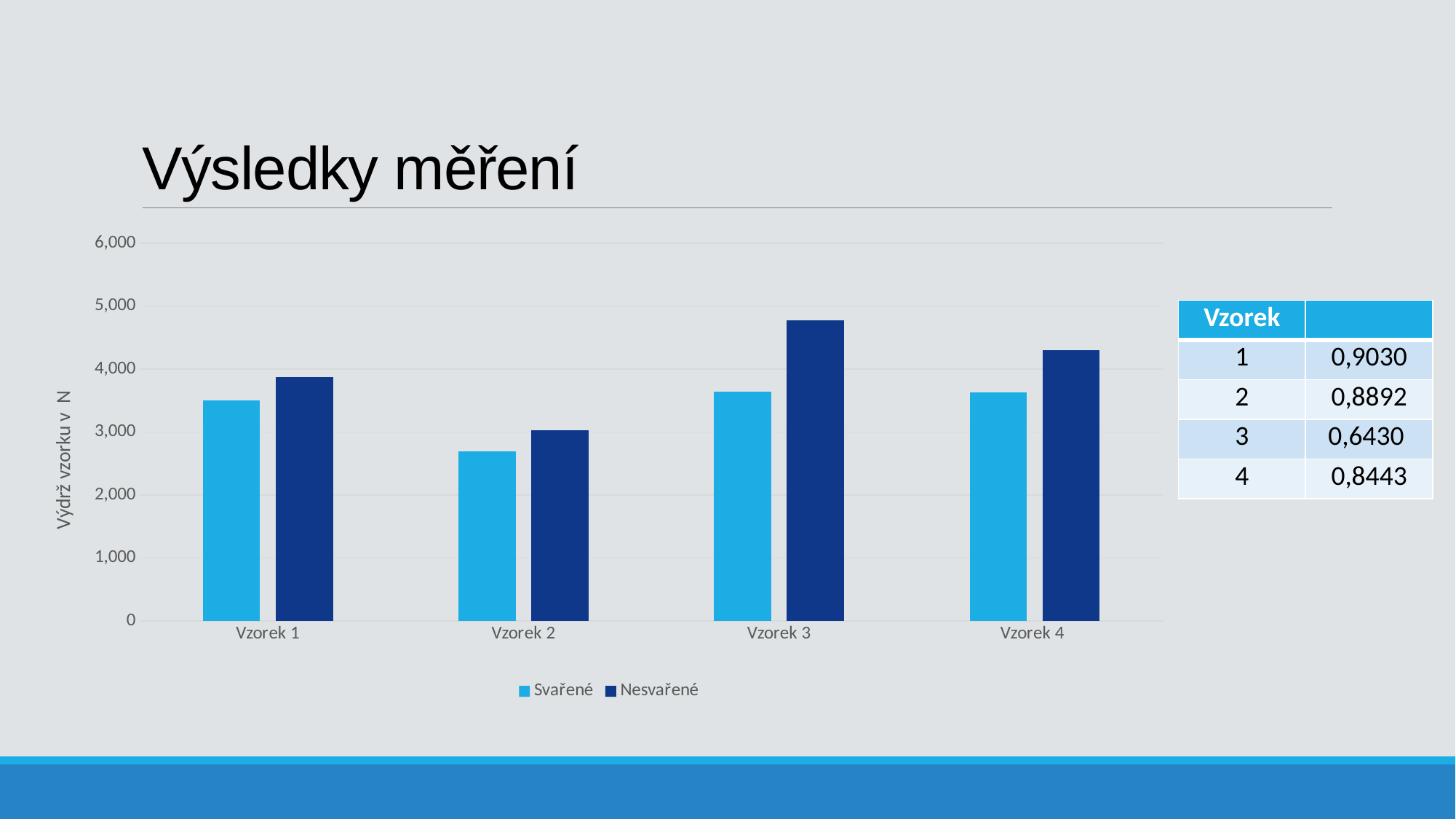
Is the Nesvařené value for Vzorek 3 greater or less than 4,000? greater What kind of chart is shown on the slide? bar chart Is the Svařené value for Vzorek 2 greater or less than 3,000? less Which category has the lowest Nesvařené value? Vzorek 2 Which category has the lowest Svařené value? Vzorek 2 Is the Svařené value for Vzorek 1 greater or less than 3,000? greater For Vzorek 1, which is larger: the Svařené value or the Nesvařené value? Nesvařené How many series does the chart legend list? 2 Which category has the highest Nesvařené value? Vzorek 3 How many categories (samples) are shown on the x axis of the chart? 4 Which is larger: the Nesvařené value for Vzorek 3 or the Nesvařené value for Vzorek 4? Vzorek 3 What is the label of the vertical axis of the chart? Výdrž vzorku v N